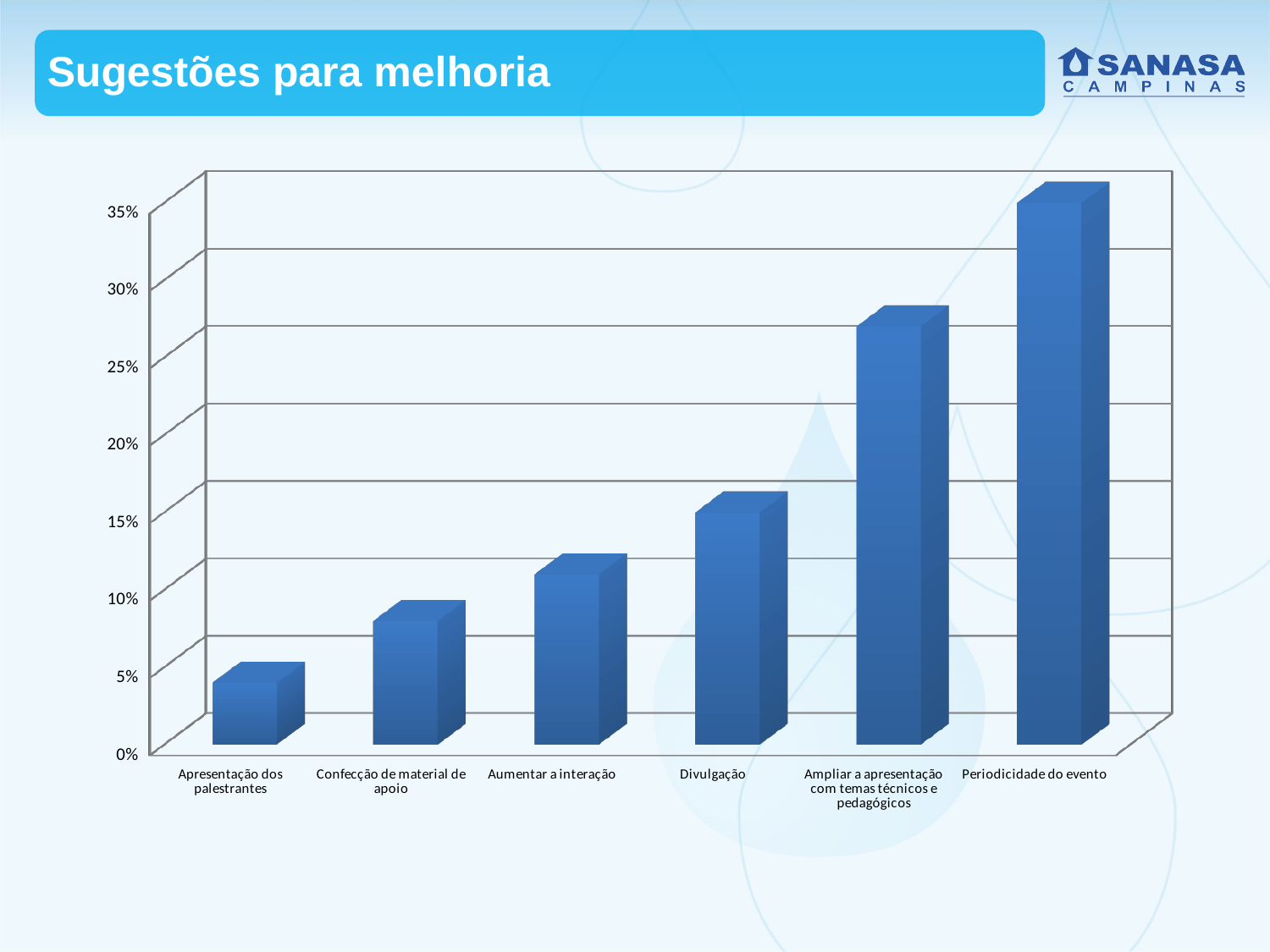
Do the values rise or fall from left to right along the x axis? rise How many categories are shown on the x axis of the chart? 6 Is the value for Confecção de material de apoio greater or less than 10%? less Is the value for Periodicidade do evento greater or less than 30%? greater What is the title shown on the slide above the chart? Sugestões para melhoria Which is larger, the value for Confecção de material de apoio or the value for Ampliar a apresentação com temas técnicos e pedagógicos? Ampliar a apresentação com temas técnicos e pedagógicos Which category has the lowest value in the chart? Apresentação dos palestrantes Is the value for Ampliar a apresentação com temas técnicos e pedagógicos greater or less than 20%? greater Which category has the highest value in the chart? Periodicidade do evento Which is larger, the value for Divulgação or the value for Aumentar a interação? Divulgação What kind of chart is shown on the slide? bar chart